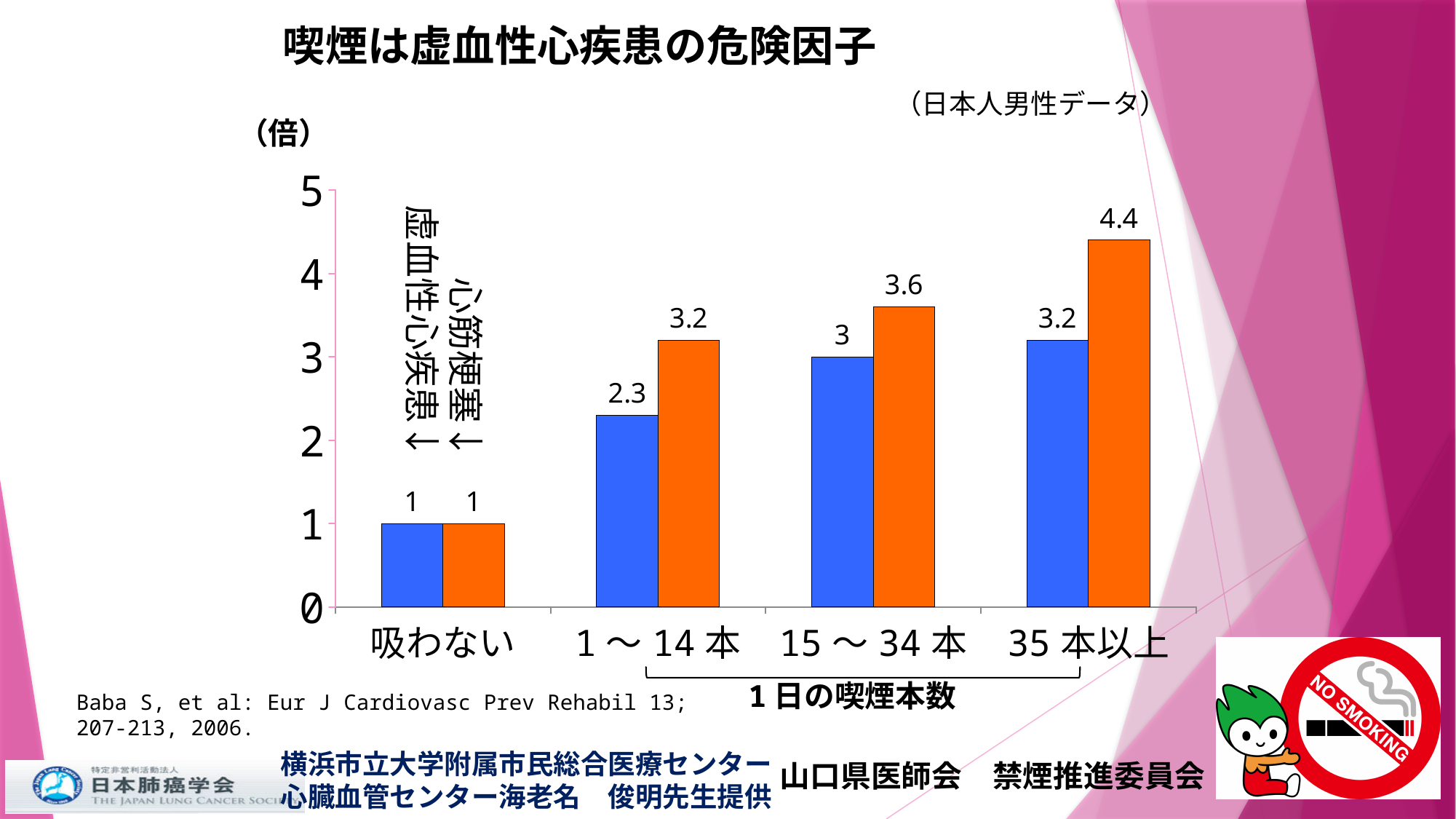
Which is larger for the 15～34本 category, the blue bar or the orange bar? the orange bar What is the value of the blue bar for the 15～34本 category? 3 What is the value of the orange bar for the 35本以上 category? 4.4 Do the orange bar values rise or fall as the number of cigarettes per day increases along the x axis? rise How many categories are shown on the x axis? 4 What unit is shown at the top of the y axis? （倍） What is the value of the blue bar for the 1～14本 category? 2.3 What is the difference between the orange and blue bars for the 35本以上 category? 1.2 What type of chart is shown on the slide? bar chart Which category has the highest orange bar? 35本以上 What is the value of the orange bar for the 吸わない category? 1 Which category has the lowest blue bar? 吸わない